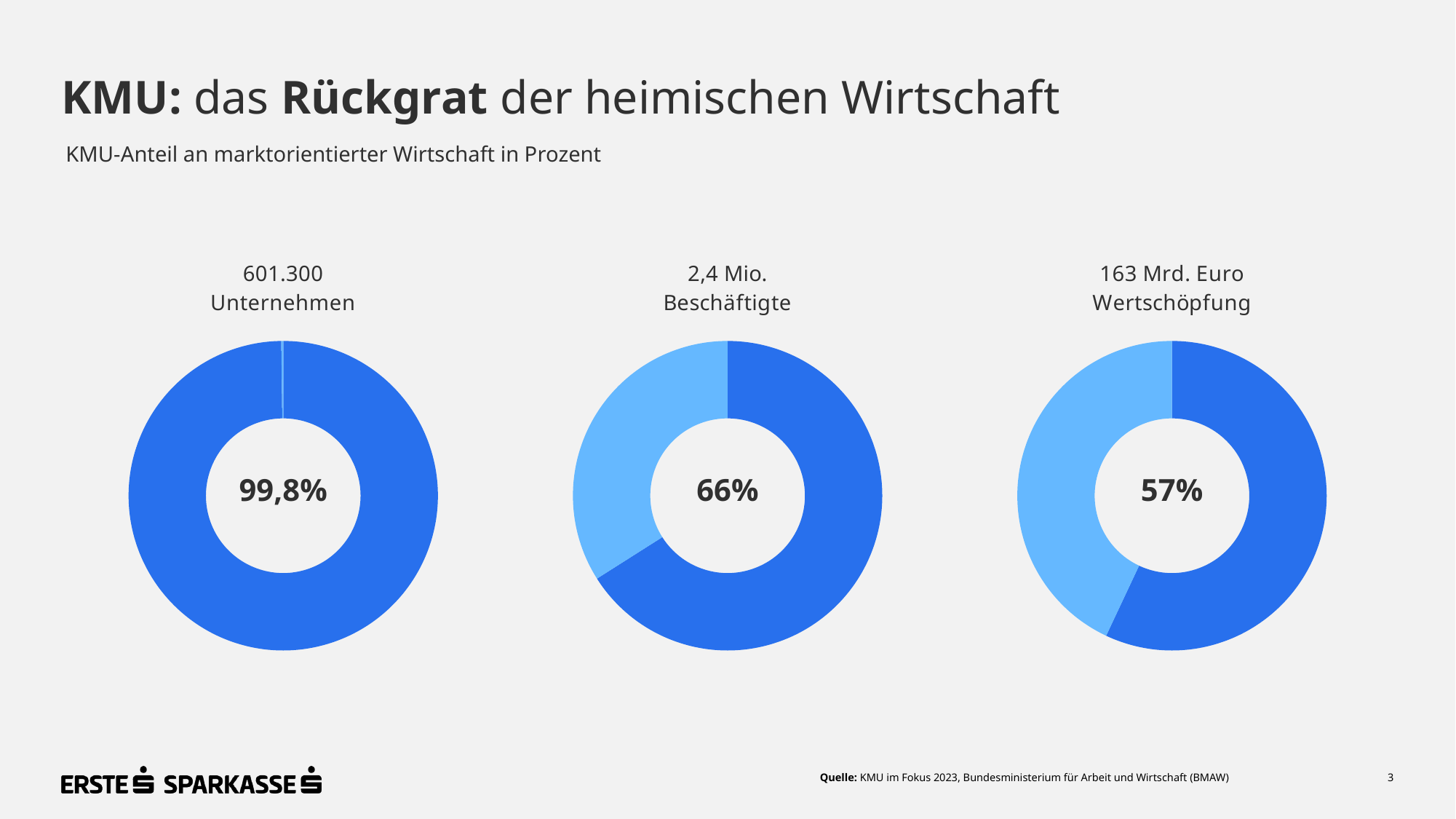
What kind of chart is used to show the three KMU shares on the slide? Donut (pie) chart How many donut charts are shown on the slide? 3 What is the difference between the KMU share for Beschäftigte and the KMU share for Wertschöpfung? 9% Which of the three donut charts shows the lowest KMU share? 163 Mrd. Euro Wertschöpfung (57%) What KMU share is shown in the centre of the donut chart labelled "163 Mrd. Euro Wertschöpfung"? 57% What is the difference between the KMU share for Unternehmen and the KMU share for Beschäftigte? 33,8% Which is larger: the KMU share for Beschäftigte or the KMU share for Wertschöpfung? Beschäftigte What KMU share is shown in the centre of the donut chart labelled "601.300 Unternehmen"? 99,8% In the donut chart labelled "163 Mrd. Euro Wertschöpfung", what share does the light blue (non-KMU) segment represent? 43% Which of the three donut charts shows the highest KMU share? 601.300 Unternehmen (99,8%) What is the subtitle printed under the slide title, describing what the donut charts show? KMU-Anteil an marktorientierter Wirtschaft in Prozent What KMU share is shown in the centre of the donut chart labelled "2,4 Mio. Beschäftigte"? 66%